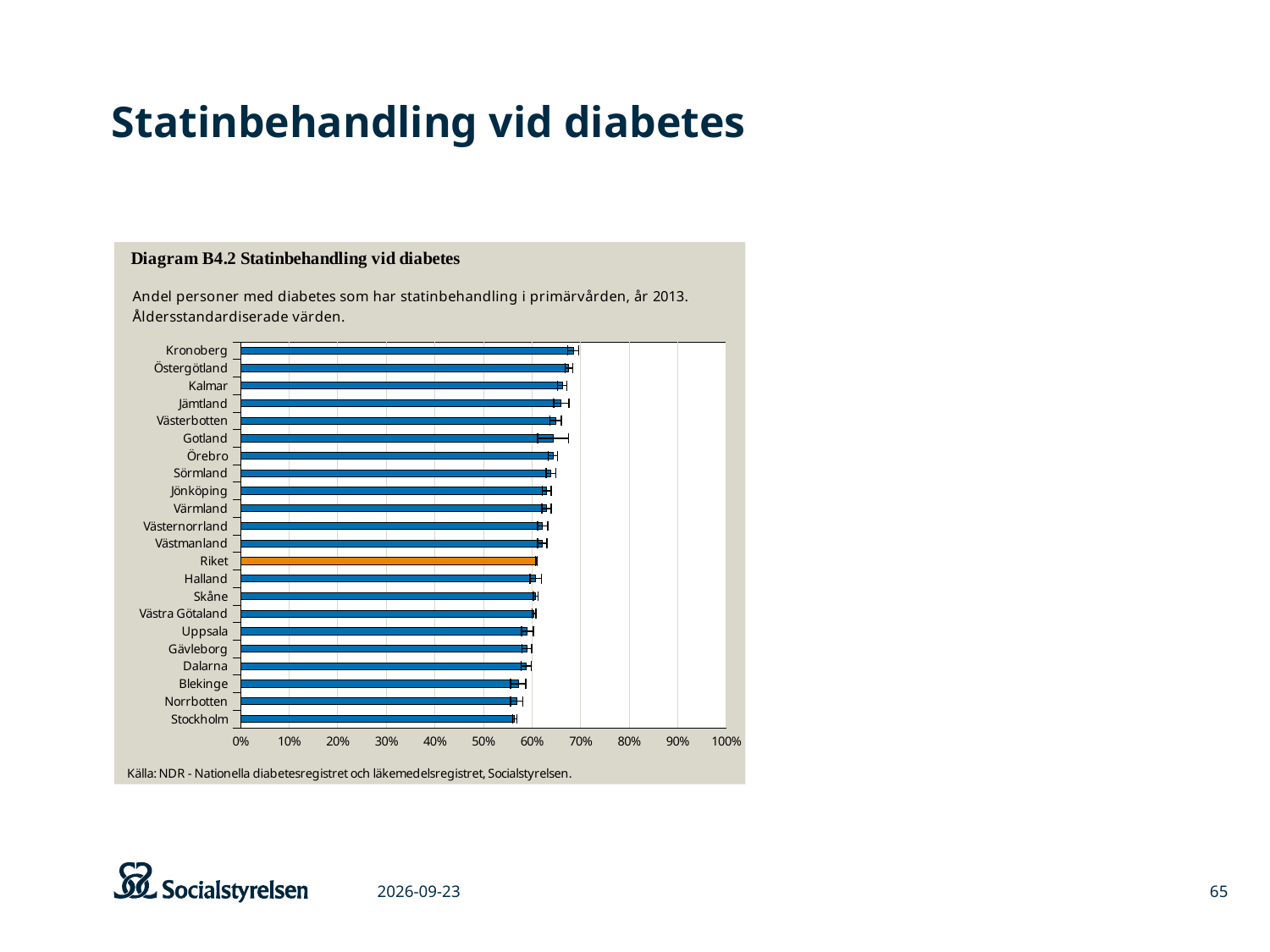
What kind of chart is shown on the slide? bar chart Which has the larger value, Kalmar or Dalarna? Kalmar What is the title of the diagram shown on the slide? Diagram B4.2 Statinbehandling vid diabetes Which has the larger value, Kronoberg or Stockholm? Kronoberg Is the value for Stockholm greater or less than 60%? less Is the value for Kronoberg greater or less than 60%? greater Which category is drawn with an orange bar instead of a blue one? Riket Is the value for Kalmar greater or less than 70%? less Which region has the highest share of statin treatment in the chart? Kronoberg Which region has the lowest share of statin treatment in the chart? Stockholm How many categories (regions including Riket) are plotted in the chart? 22